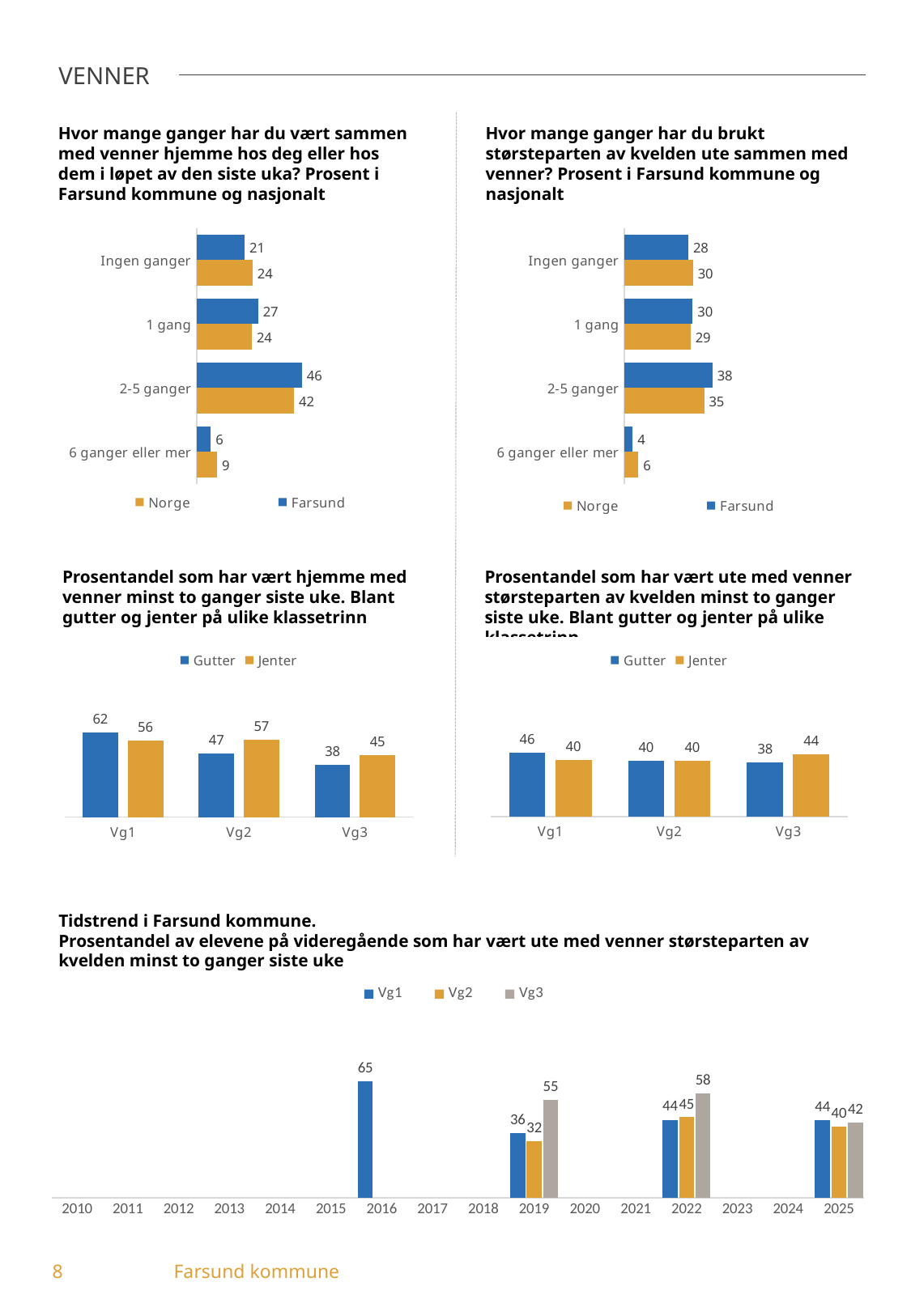
In the bottom chart (Tidstrend i Farsund kommune), what is the difference between the Vg1 values in 2016 and 2019? 29 In the top-right chart (Hvor mange ganger har du brukt størsteparten av kvelden ute sammen med venner), how many categories are shown? 4 In the top-right chart (Hvor mange ganger har du brukt størsteparten av kvelden ute sammen med venner), which category has the lowest value for Farsund? 6 ganger eller mer In the bottom chart (Tidstrend i Farsund kommune), what is the value for Vg3 in 2022? 58 In the middle-right chart (Prosentandel som har vært ute med venner størsteparten av kvelden), how many series does the legend list? 2 In the middle-right chart (Prosentandel som har vært ute med venner størsteparten av kvelden), is the value for Gutter or Jenter larger at Vg3? Jenter In the top-left chart (Hvor mange ganger har du vært sammen med venner hjemme), what is the difference between the Norge and Farsund values for '6 ganger eller mer'? 3 In the top-right chart (Hvor mange ganger har du brukt størsteparten av kvelden ute sammen med venner), what is the value for Norge in the 'Ingen ganger' category? 30 What kind of chart is the bottom chart (Tidstrend i Farsund kommune)? Bar chart In the top-left chart (Hvor mange ganger har du vært sammen med venner hjemme), what is the value for Farsund in the '2-5 ganger' category? 46 In the middle-left chart (Prosentandel som har vært hjemme med venner minst to ganger siste uke), what is the value for Jenter at Vg2? 57 In the middle-left chart (Prosentandel som har vært hjemme med venner minst to ganger siste uke), which group has the highest value overall? Gutter at Vg1